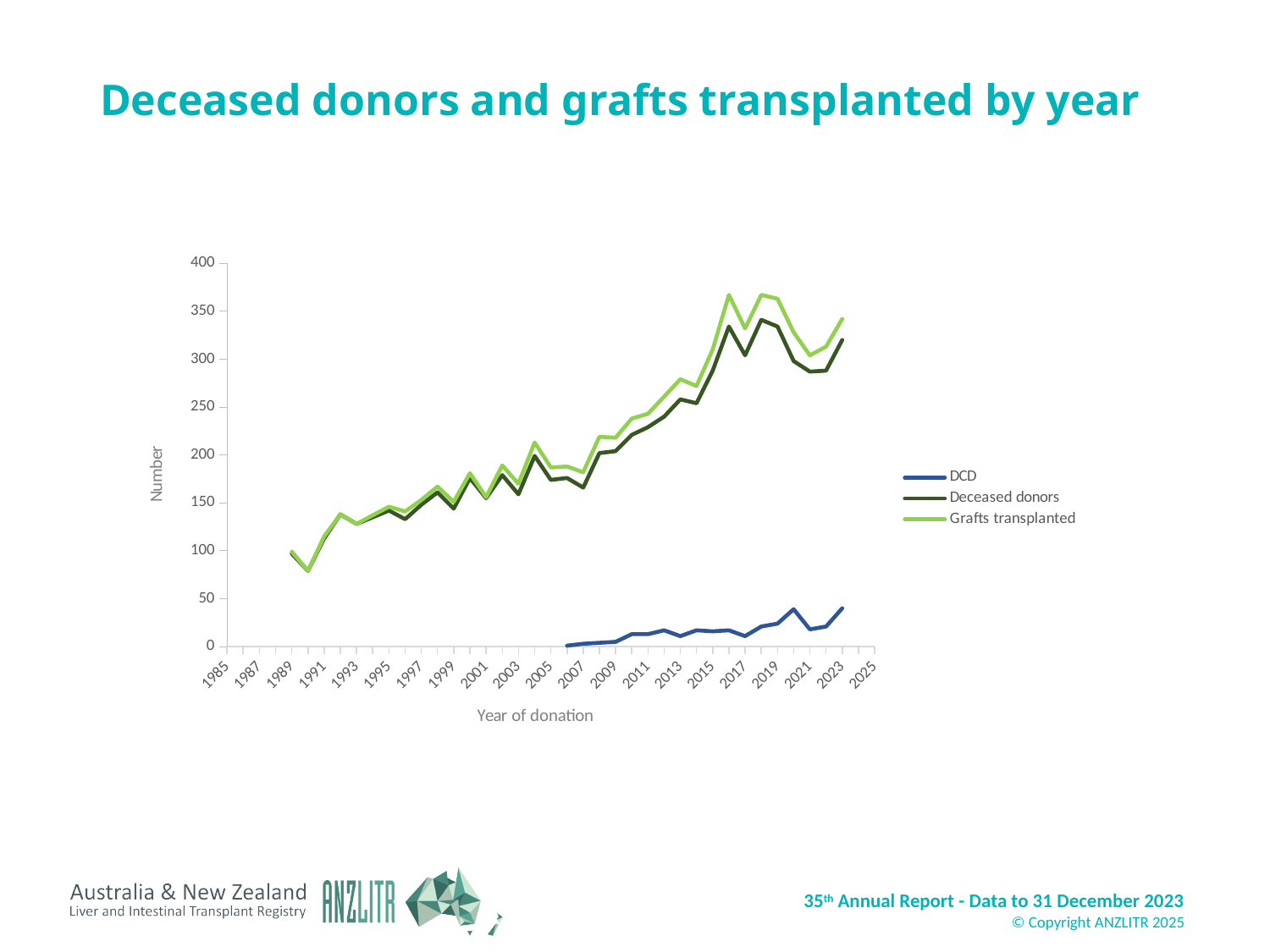
Is the value for Grafts transplanted in 2017 greater or less than 350? less In 2023, which is larger: DCD or Deceased donors? Deceased donors Is the value for Deceased donors in 2021 greater or less than 300? less How many series does the legend list? 3 What kind of chart is shown on the slide? Line chart Is the value for Grafts transplanted in 1990 greater or less than 100? less In 2017, which is larger: Grafts transplanted or Deceased donors? Grafts transplanted Do the Deceased donors values generally rise or fall from 1989 to 2017? rise What is the label of the x axis? Year of donation What are the three series listed in the legend? DCD, Deceased donors, Grafts transplanted